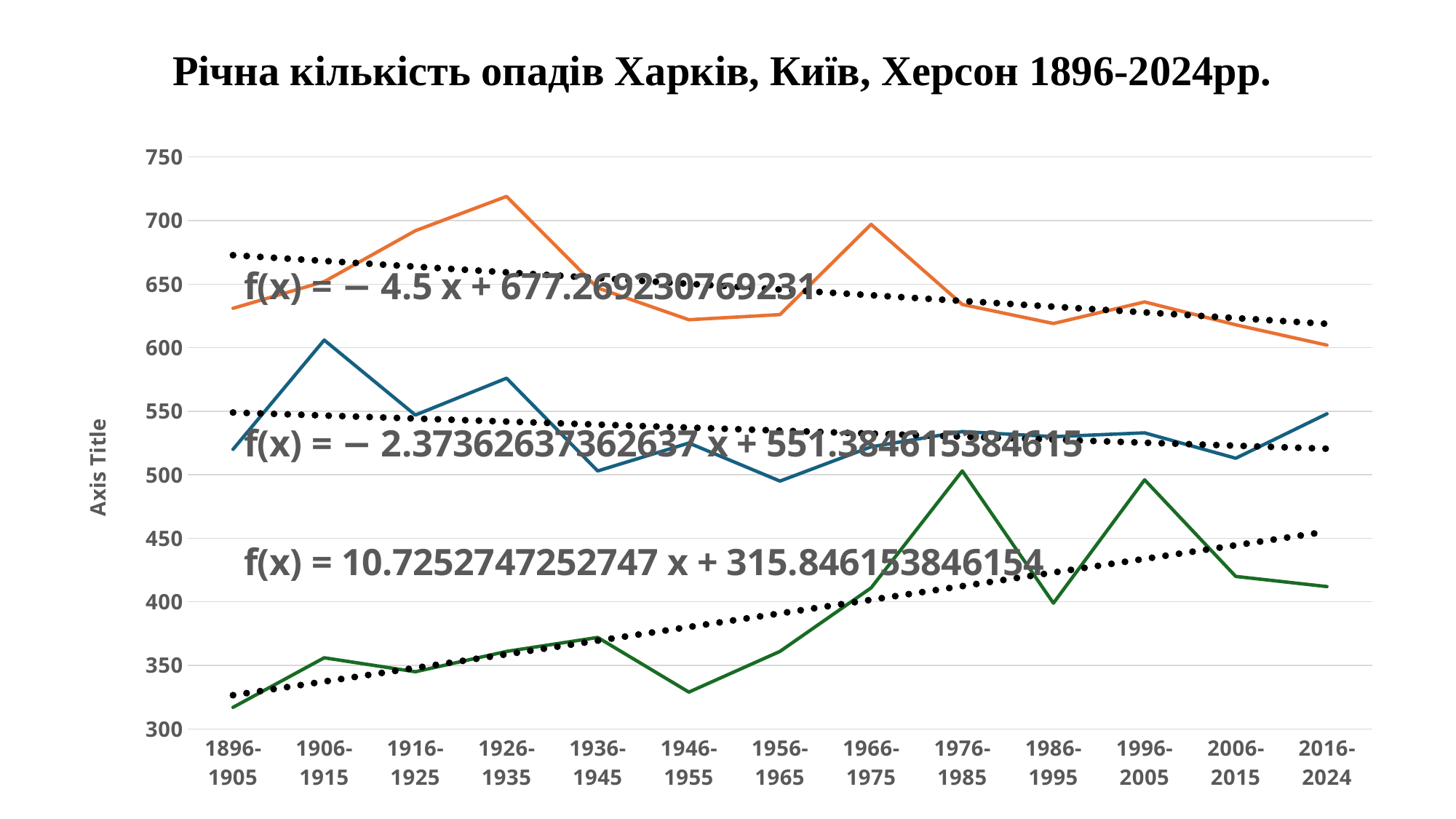
Is the value of the orange line for 1926-1935 greater or less than 700? greater Which is larger for the orange line: the value for 1896-1905 or the value for 2016-2024? 1896-1905 In which period does the orange line reach its highest value? 1926-1935 What is the title of the chart? Річна кількість опадів Харків, Київ, Херсон 1896-2024рр. Does the green line rise or fall overall from 1896-1905 to 2016-2024? rise How many solid data lines are plotted on the chart? 3 Is the value of the blue line for 1896-1905 greater or less than 550? less How many time periods are shown along the x axis? 13 Does the orange line rise or fall overall from 1896-1905 to 2016-2024? fall What kind of chart is shown on the slide? line chart Is the value of the green line for 1896-1905 greater or less than 350? less